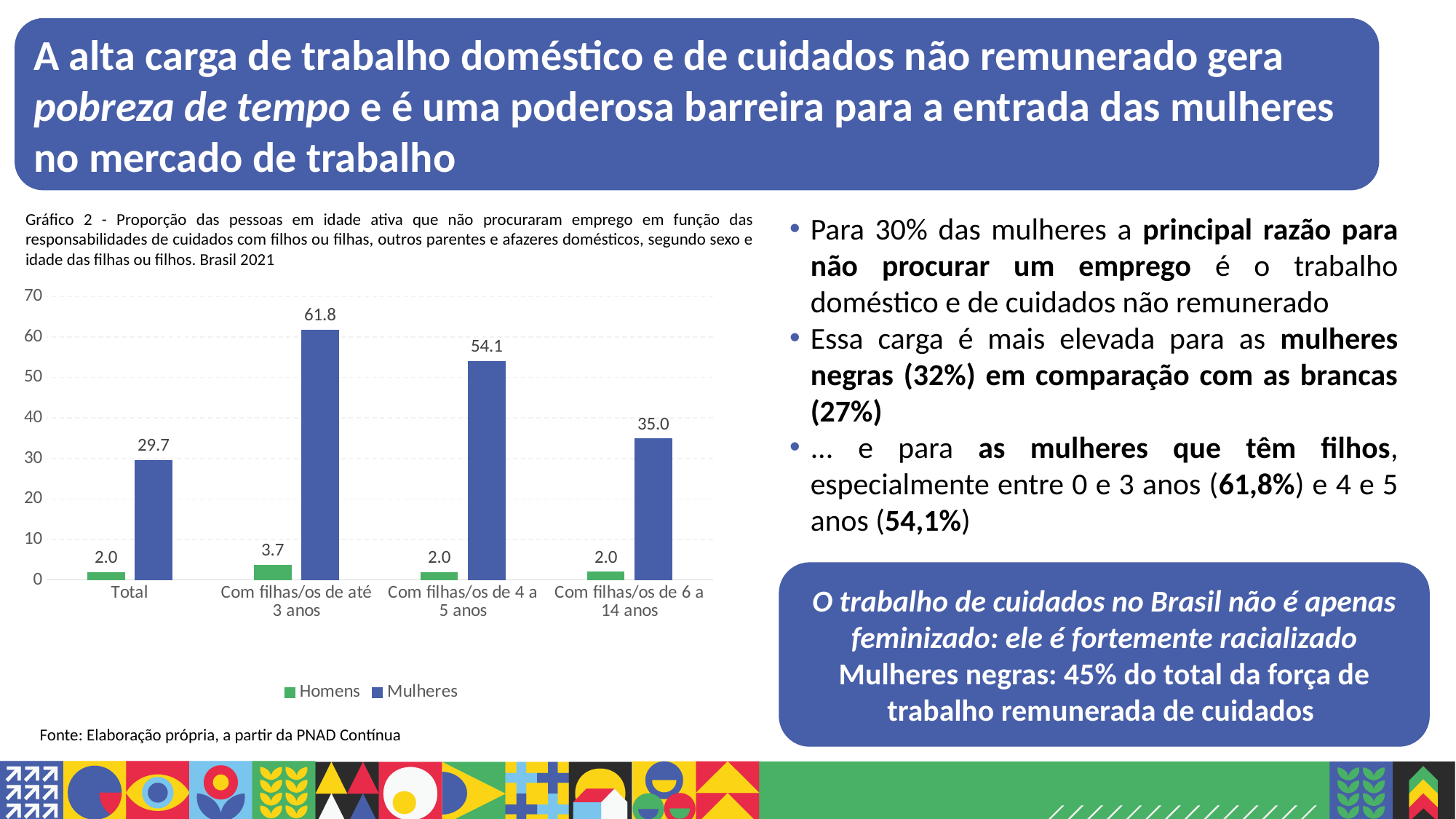
How many series does the chart legend list? 2 What is the value for Mulheres in the 'Com filhas/os de até 3 anos' category? 61.8 Which category has the lowest value for Mulheres? Total What kind of chart is shown on the slide? Bar chart Which is larger: the Mulheres value for 'Com filhas/os de 4 a 5 anos' or for 'Com filhas/os de 6 a 14 anos'? Com filhas/os de 4 a 5 anos Which category has the highest value for Mulheres? Com filhas/os de até 3 anos What is the value for Homens in the 'Com filhas/os de até 3 anos' category? 3.7 What is the value for Mulheres in the 'Com filhas/os de 6 a 14 anos' category? 35.0 Which series is shown in green in the chart? Homens What is the difference between the Mulheres values for 'Com filhas/os de até 3 anos' and 'Com filhas/os de 4 a 5 anos'? 7.7 What is the value for Mulheres in the 'Total' category? 29.7 How many categories are shown on the x axis of the chart? 4